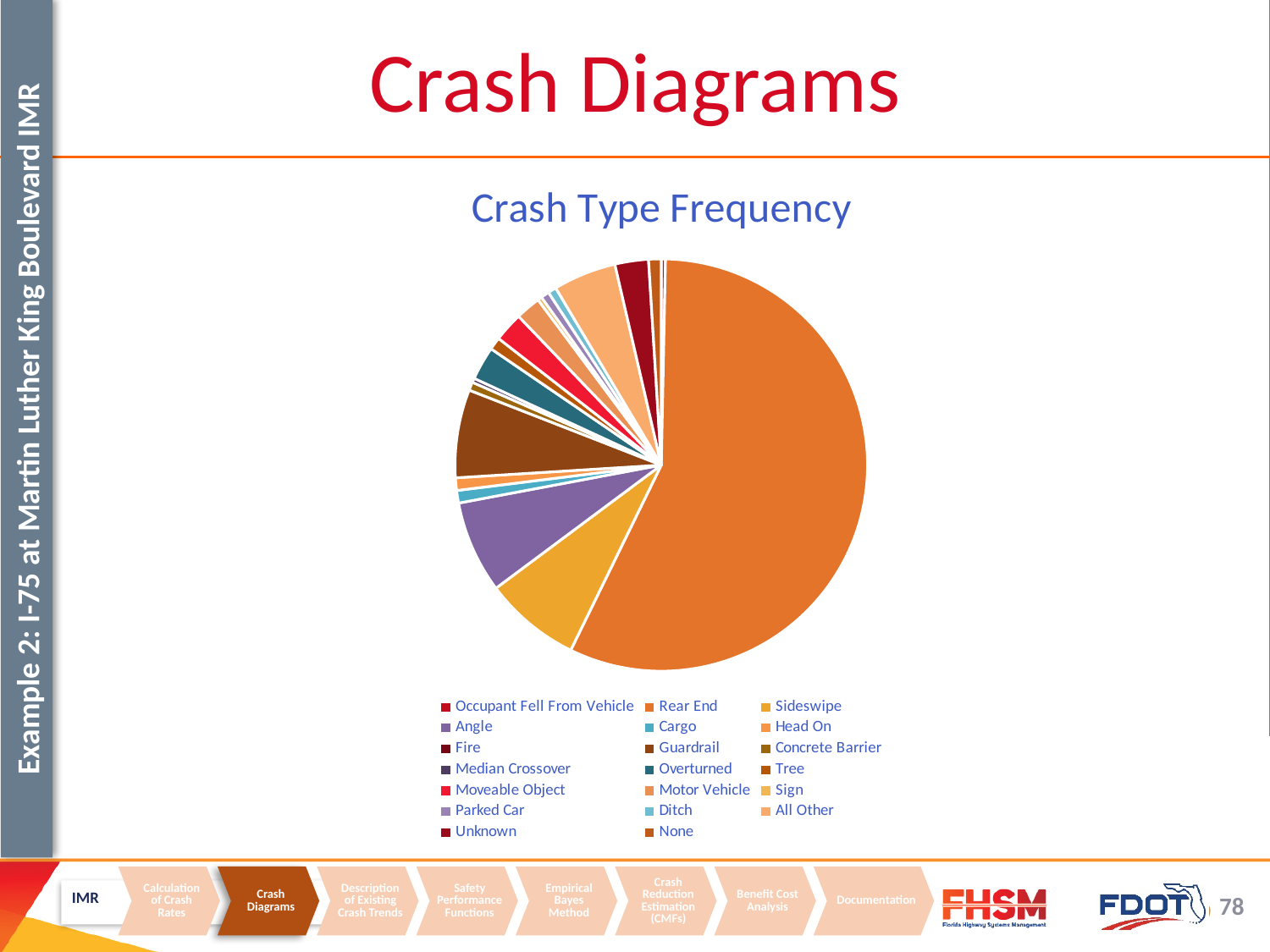
Which is larger, the slice for Rear End or the slice for Sideswipe? Rear End Which is larger, the slice for Angle or the slice for Concrete Barrier? Angle What colour is used for the Rear End slice? Orange What is the title of the chart? Crash Type Frequency Which crash type has the largest slice of the pie? Rear End Which is larger, the slice for Sideswipe or the slice for Overturned? Sideswipe What kind of chart is shown on the slide? Pie chart How many crash types does the legend list? 20